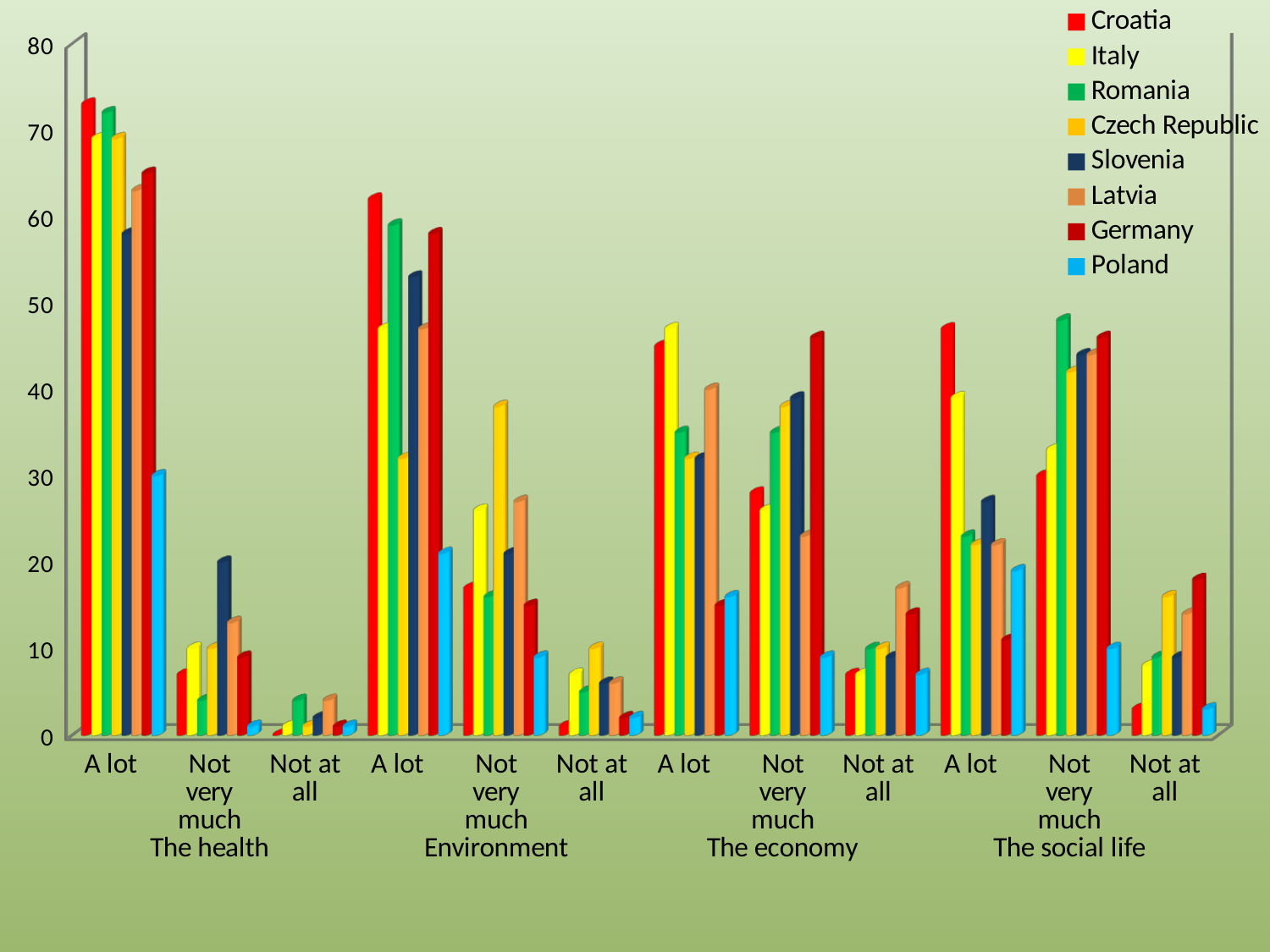
Which country has the lowest value under 'A lot' in The health group? Poland Which country is listed first in the legend? Croatia Under 'Not very much' in The social life group, which is larger: the value for Romania or the value for Croatia? Romania Is the value for Czech Republic under 'Not very much' in the Environment group greater or less than 30? greater Is the value for Germany under 'Not very much' in The economy group greater or less than 40? greater Which country has the highest value under 'Not very much' in the Environment group? Czech Republic What colour represents Poland in the chart? Light blue Is the value for Poland under 'A lot' in the Environment group greater or less than 30? less How many topic groups (such as The health, Environment) are shown along the x axis? 4 How many series does the legend list? 8 What kind of chart is shown on the slide? Bar chart